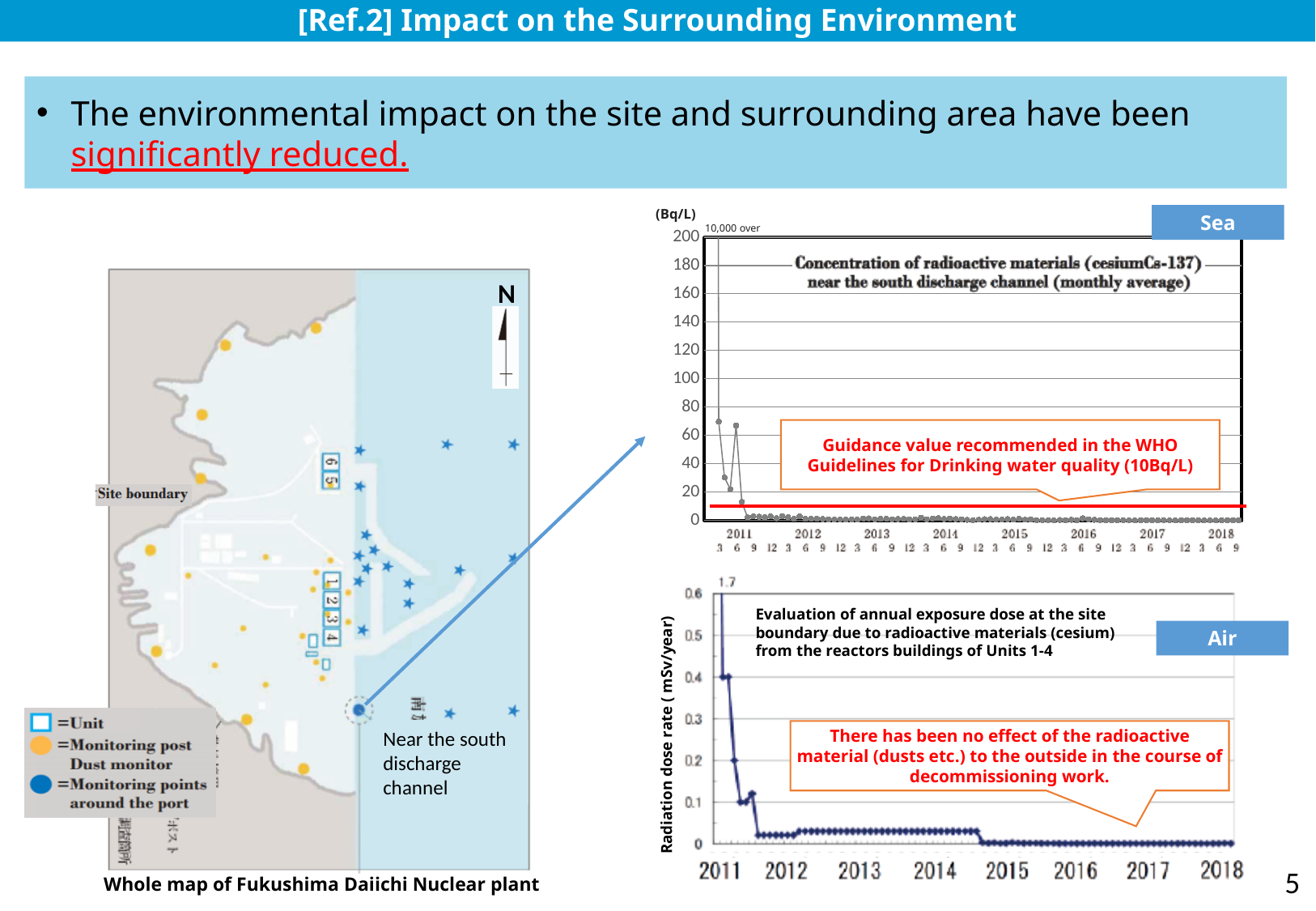
In the Air chart, does the radiation dose rate rise or fall from 2011 to 2018? fall In the Air chart, is the radiation dose rate in 2013 greater or less than 0.1 mSv/year? less What unit is used on the y axis of the Air chart? mSv/year What kind of chart is the Sea chart showing the concentration of radioactive materials near the south discharge channel? line chart In the Air chart, which year has the larger radiation dose rate, 2012 or 2017? 2012 In the Air chart, is the radiation dose rate in 2018 greater or less than 0.1 mSv/year? less In the Sea chart, is the concentration value in early 2011 greater or less than 40 Bq/L? greater What is the highest value shown on the y axis of the Sea chart? 200 In the Sea chart, do the concentration values rise or fall from 2011 to 2018? fall What kind of chart is the Air chart showing the radiation dose rate at the site boundary? line chart In the Sea chart, what guidance value recommended in the WHO Guidelines for Drinking water quality is marked by the red line? 10Bq/L